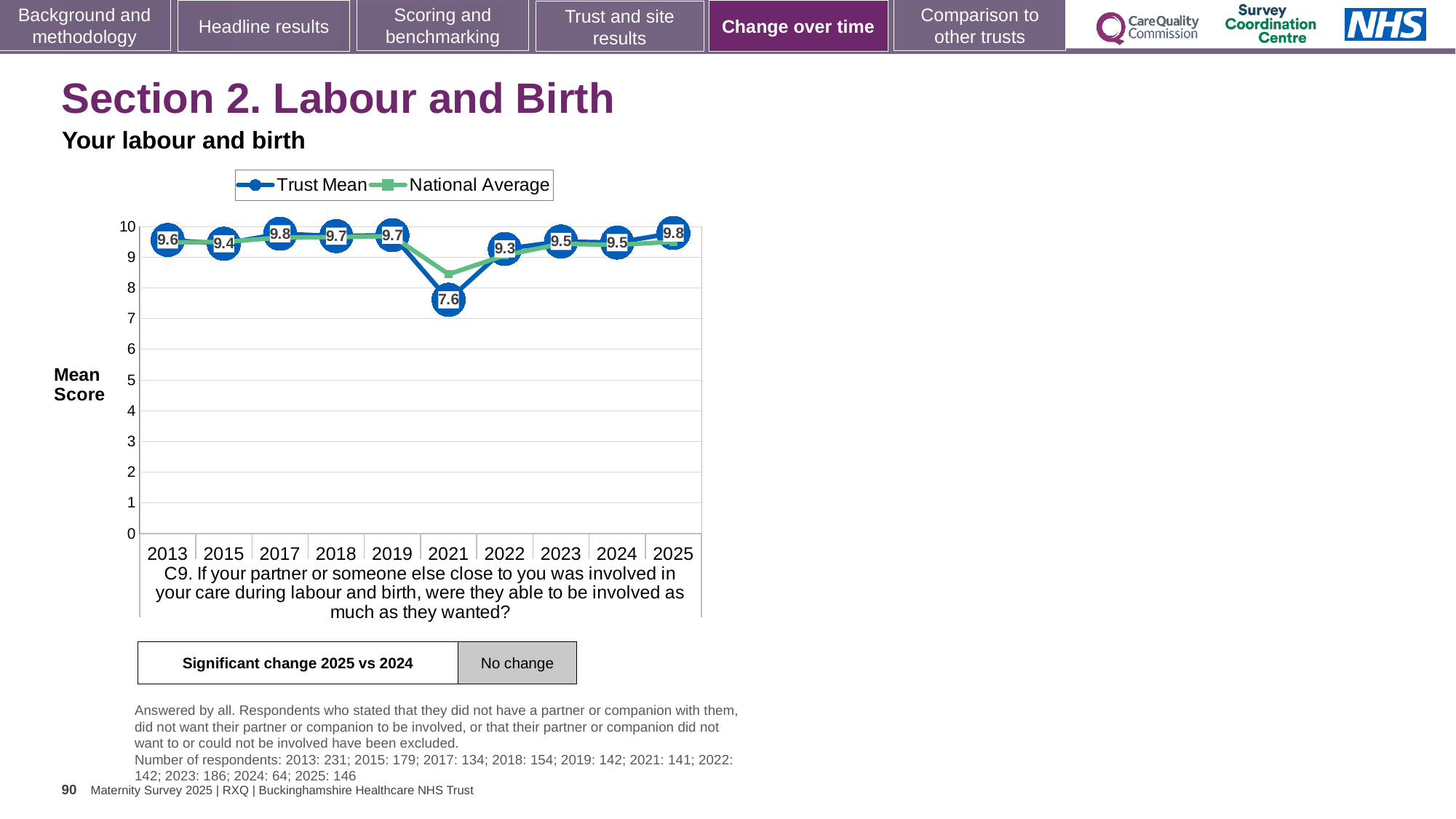
Is the National Average value for 2021 greater or less than 8? greater What is the Trust Mean value for 2013? 9.6 In which year is the Trust Mean lowest? 2021 What type of chart is shown on the slide? line chart What is the difference between the Trust Mean in 2019 and in 2021? 2.1 How many years are plotted on the x axis? 10 How many series does the legend list? 2 What is the Trust Mean value for 2025? 9.8 What is the Trust Mean value for 2022? 9.3 Which is larger, the Trust Mean for 2017 or for 2022? 2017 What is the Trust Mean value for 2021? 7.6 What is the difference between the Trust Mean in 2025 and in 2024? 0.3